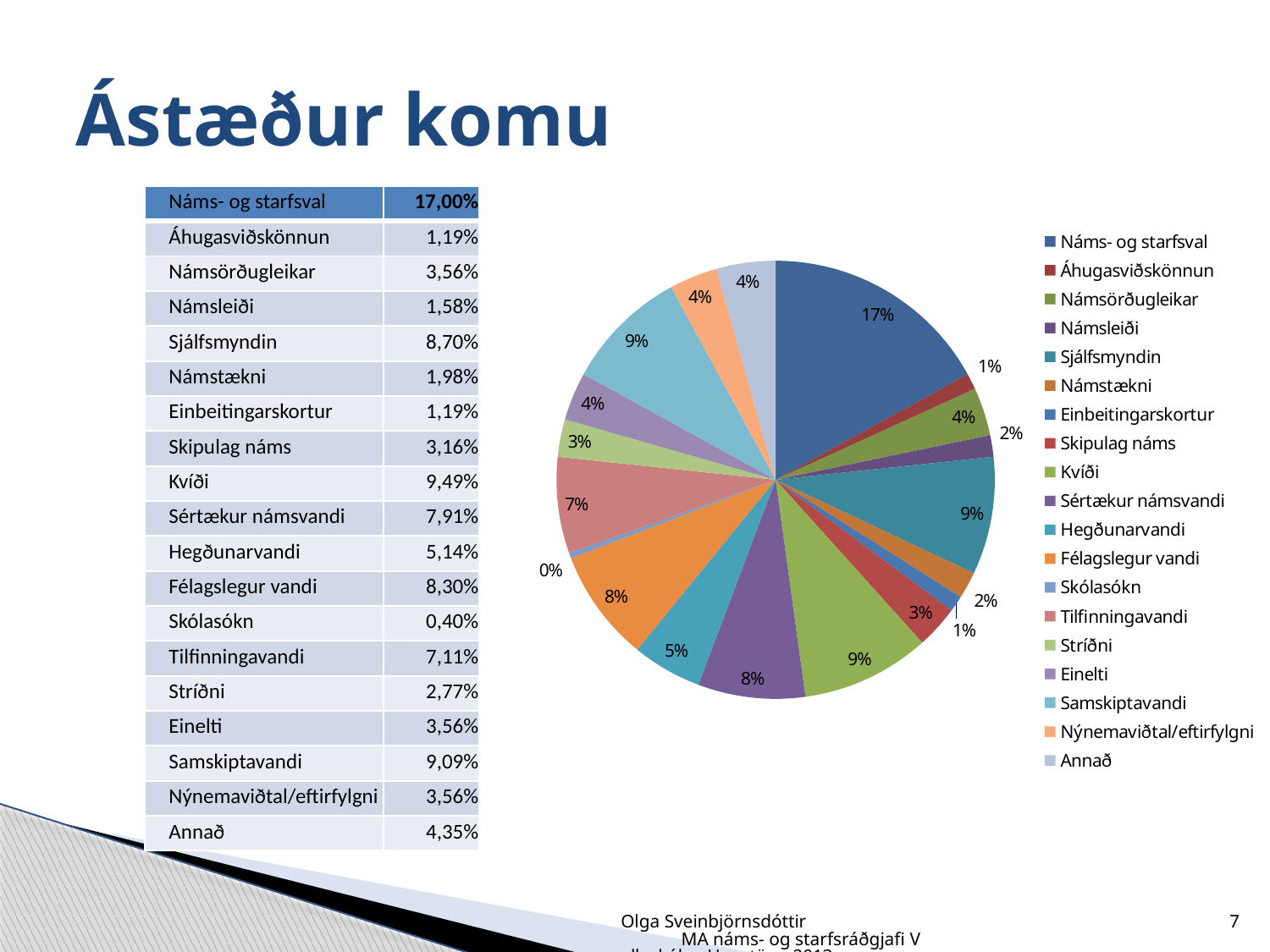
What percentage does the pie chart show for Hegðunarvandi? 5% What is the title of the slide containing the pie chart? Ástæður komu Which category has the smallest slice in the pie chart? Skólasókn What percentage does the pie chart show for Náms- og starfsval? 17% By how many percentage points does the Náms- og starfsval slice exceed the Hegðunarvandi slice in the pie chart? 12 percentage points How many categories does the pie chart legend list? 19 What kind of chart is shown on the slide? pie chart Which category has the largest slice in the pie chart? Náms- og starfsval In the pie chart, which is larger: Náms- og starfsval or Sjálfsmyndin? Náms- og starfsval What percentage does the pie chart show for Tilfinningavandi? 7% What percentage does the pie chart show for Sjálfsmyndin? 9% In the pie chart, which is larger: Tilfinningavandi or Hegðunarvandi? Tilfinningavandi